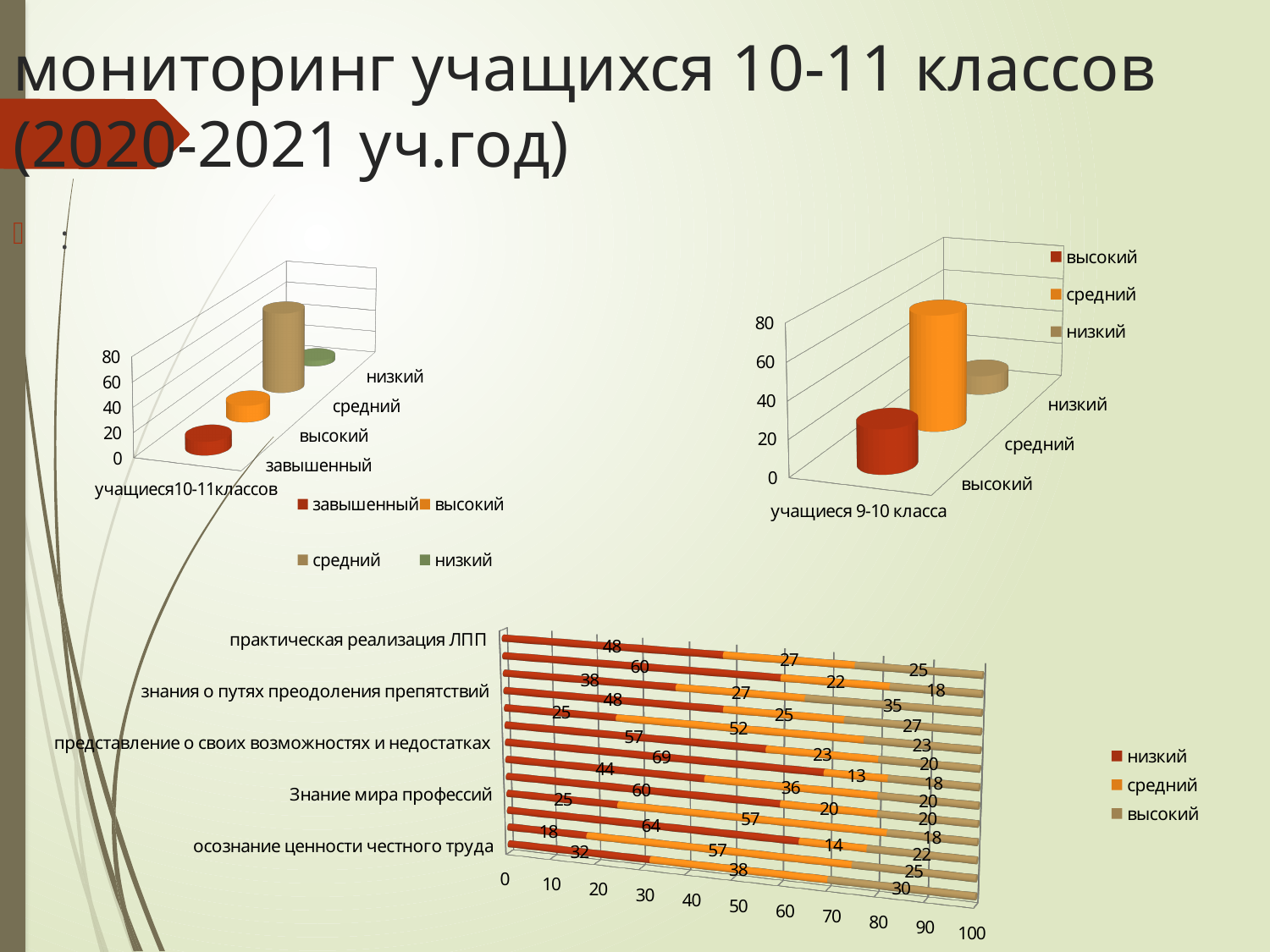
In the bottom chart, what is the total of the bottom-most stacked bar (32, 38, 30)? 100 In the bottom chart, how many series does the legend list? 3 In the top-left chart (учащиеся10-11классов), how many series does the legend list? 4 How many charts are on the slide? 3 In the top-right chart (учащиеся 9-10 класса), is the value for высокий greater or less than 40? less In the top-left chart (учащиеся10-11классов), which category has the highest value? средний In the top-left chart (учащиеся10-11классов), is the value for средний greater or less than 40? greater In the top-right chart (учащиеся 9-10 класса), which is larger, средний or низкий? средний In the top-left chart (учащиеся10-11классов), is the value for завышенный greater or less than 20? less What kind of chart is the bottom chart on the slide? bar chart In the top-right chart (учащиеся 9-10 класса), how many series does the legend list? 3 In the top-right chart (учащиеся 9-10 класса), which category has the highest value? средний